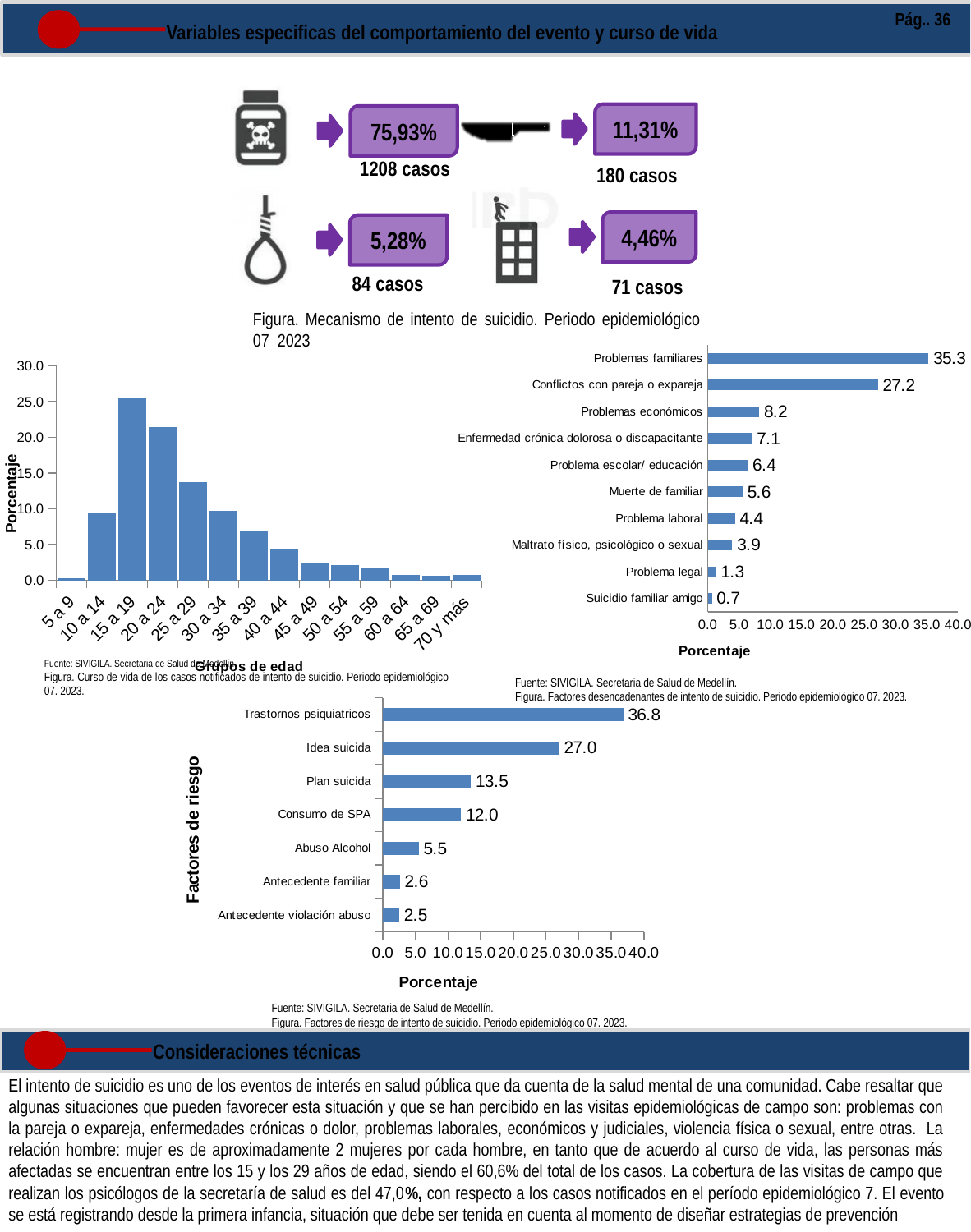
In the 'Factores de riesgo' chart (bottom), which category has the highest value? Trastornos psiquiatricos In the 'Factores de riesgo' chart (bottom), which is larger: Plan suicida or Abuso Alcohol? Plan suicida In the 'Factores de riesgo' chart (bottom), how many categories are plotted? 7 In the age group chart (left, 'Grupos de edad'), is the value for 15 a 19 greater or less than 20.0? greater In the 'Factores desencadenantes' chart (right side), which category has the lowest value? Suicidio familiar amigo In the 'Factores de riesgo' chart (bottom), what is the value for Consumo de SPA? 12.0 In the 'Factores desencadenantes' chart (right side), what is the difference between Problemas familiares and Conflictos con pareja o expareja? 8.1 In the 'Factores de riesgo' chart (bottom), what is the difference between Trastornos psiquiatricos and Idea suicida? 9.8 In the age group chart (left, 'Grupos de edad'), how many age groups are shown on the x axis? 14 In the age group chart (left, 'Grupos de edad'), which age group has the highest percentage? 15 a 19 In the 'Factores desencadenantes' chart (right side), how many categories are plotted? 10 In the 'Factores desencadenantes' chart (right side), what is the value for Problemas familiares? 35.3